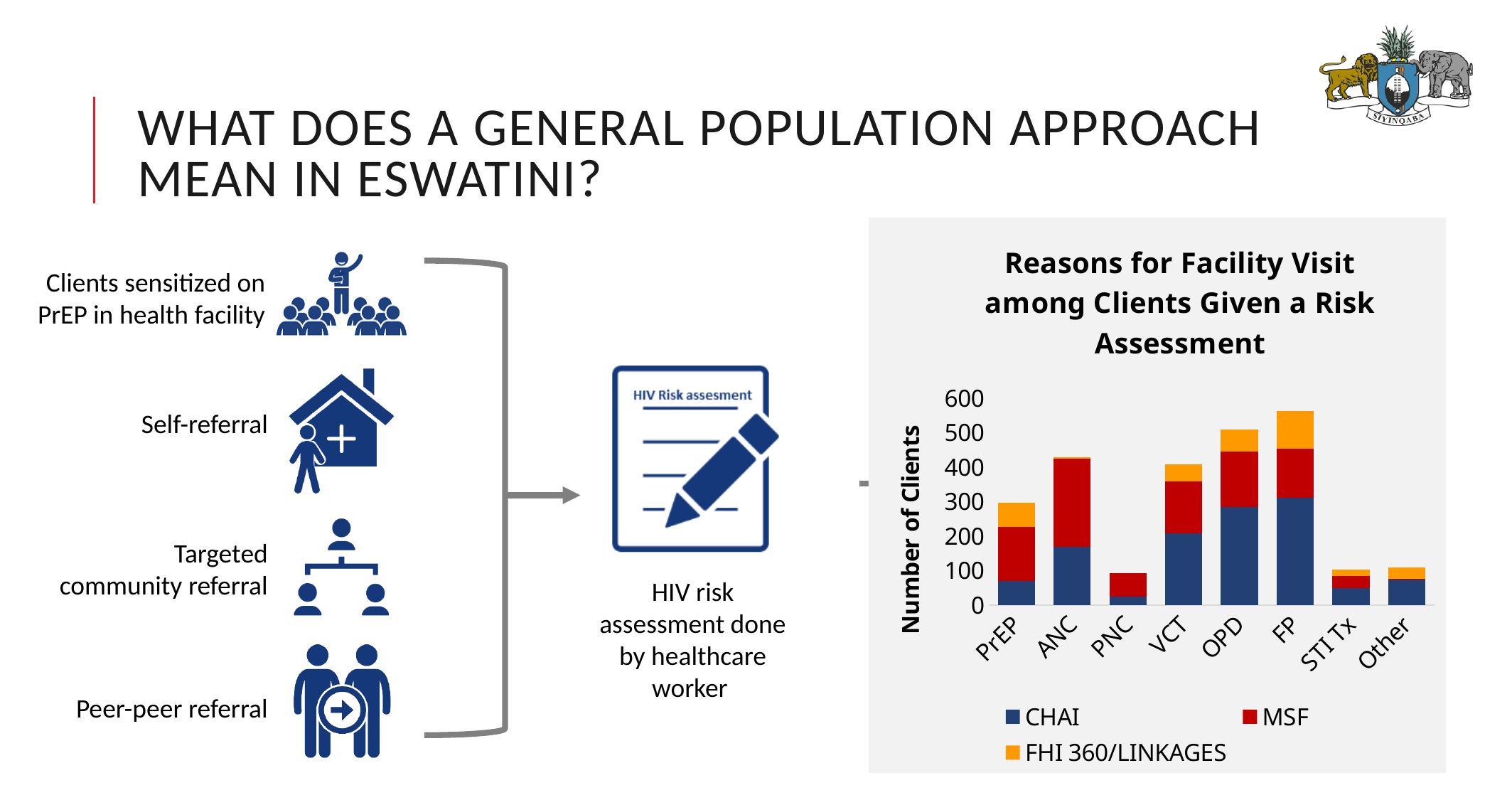
Which reason for facility visit has the highest total number of clients? FP Is the total number of clients for STI Tx greater or less than 200? less Is the total number of clients for FP greater or less than 500? greater What kind of chart is 'Reasons for Facility Visit among Clients Given a Risk Assessment'? stacked bar chart How many reasons for facility visit (categories) are shown on the x axis of the chart? 8 How many series does the chart's legend list? 3 Which has a larger total number of clients, OPD or VCT? OPD What is the label of the y axis of the chart? Number of Clients Is the total number of clients for OPD greater or less than 400? greater Which category has the largest MSF segment in the chart? ANC Which has a larger total number of clients, ANC or PrEP? ANC